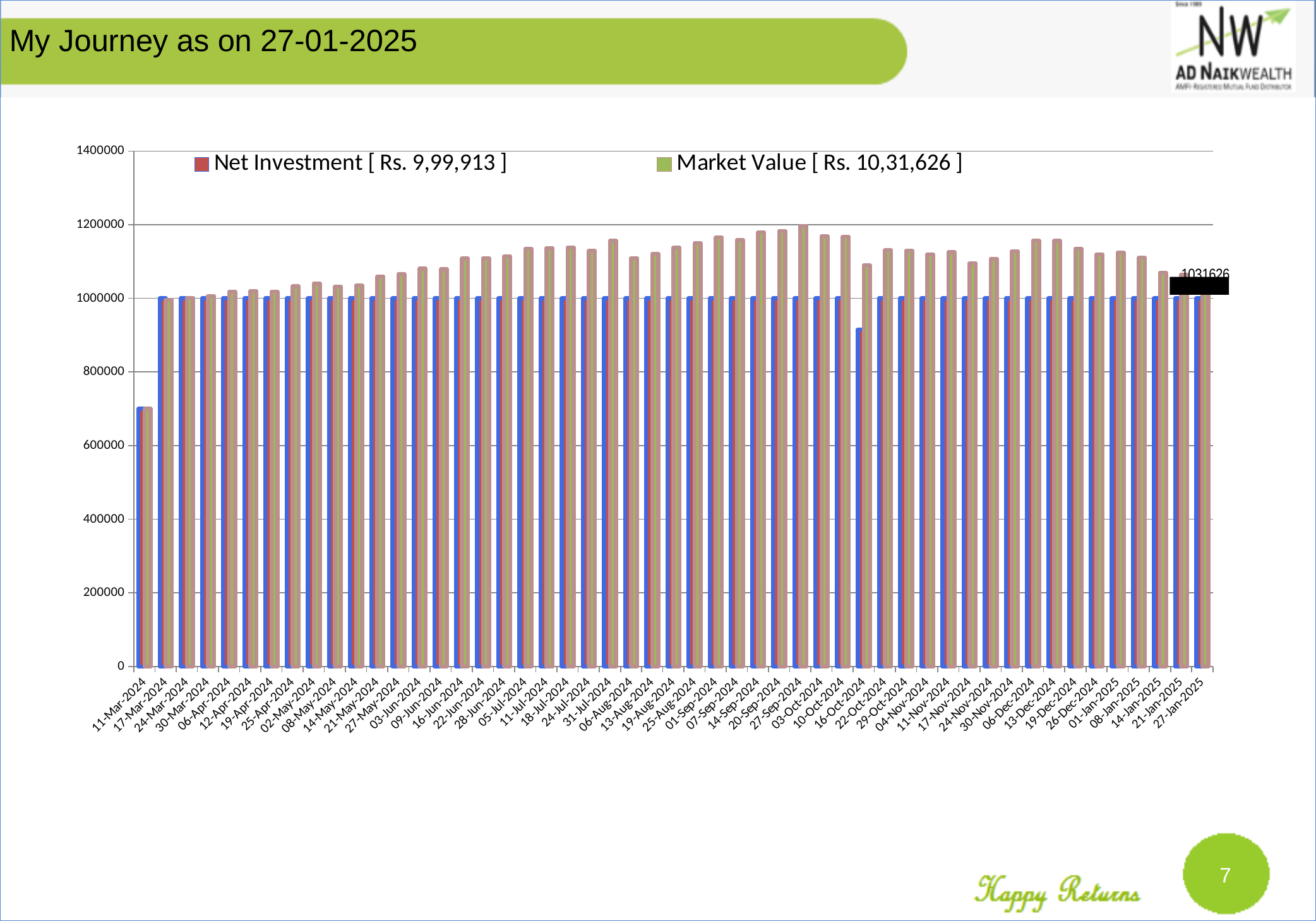
Is the Market Value on 27-Sep-2024 greater or less than 1000000? greater Is the Net Investment on 16-Oct-2024 greater or less than 1000000? less Is the Market Value on 11-Mar-2024 greater or less than 800000? less On which date is the Market Value lowest? 11-Mar-2024 On 27-Sep-2024, which is larger: Net Investment or Market Value? Market Value What kind of chart is shown on the slide? bar chart Does the Market Value rise or fall from 11-Mar-2024 to 27-Sep-2024? rise What is the Market Value shown by the data label on 27-Jan-2025? 1031626 On which date is the Market Value highest? 27-Sep-2024 What Market Value amount is shown in the legend entry? Rs. 10,31,626 How many series does the chart legend list? 2 What Net Investment amount is shown in the legend entry? Rs. 9,99,913